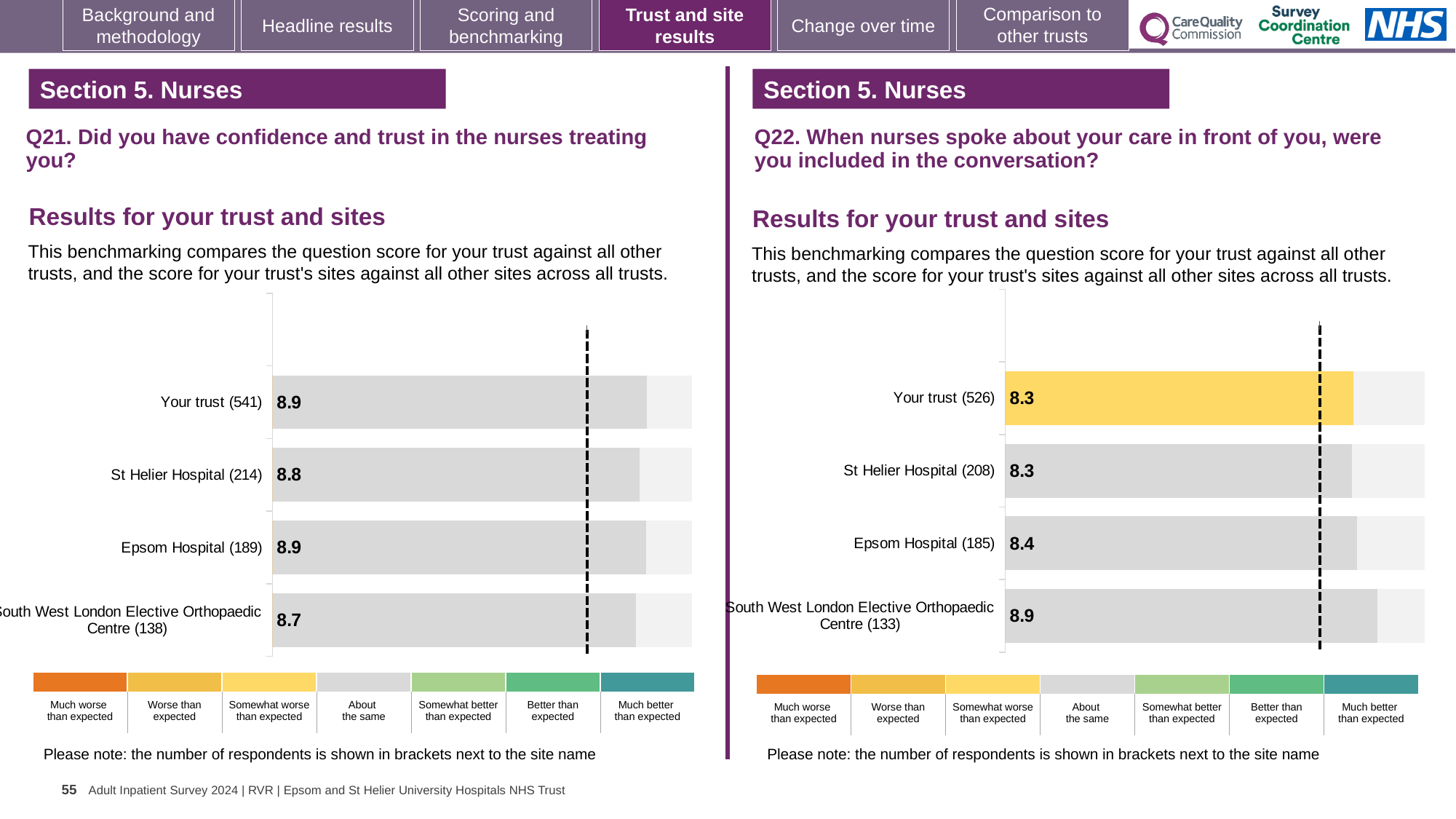
What type of chart is used for the Q22 results (right)? Bar chart In the Q22 chart (right), what is the score for South West London Elective Orthopaedic Centre (133)? 8.9 In the Q21 chart (left), what is the score for St Helier Hospital (214)? 8.8 In the Q22 chart (right), what is the difference between the scores for South West London Elective Orthopaedic Centre (133) and Your trust (526)? 0.6 In the Q21 chart (left), what is the difference between the scores for Your trust (541) and South West London Elective Orthopaedic Centre (138)? 0.2 In the Q21 chart (left), what is the score for South West London Elective Orthopaedic Centre (138)? 8.7 In the Q21 chart (left), which site has the lowest score? South West London Elective Orthopaedic Centre (138) In the Q22 chart (right), which is larger: the score for Epsom Hospital (185) or St Helier Hospital (208)? Epsom Hospital (185) In the Q22 chart (right), what is the score for Epsom Hospital (185)? 8.4 In the Q21 chart (left), what is the score for Your trust (541)? 8.9 In the Q22 chart (right), which site has the highest score? South West London Elective Orthopaedic Centre (133) How many bars are shown in the Q21 chart (left)? 4